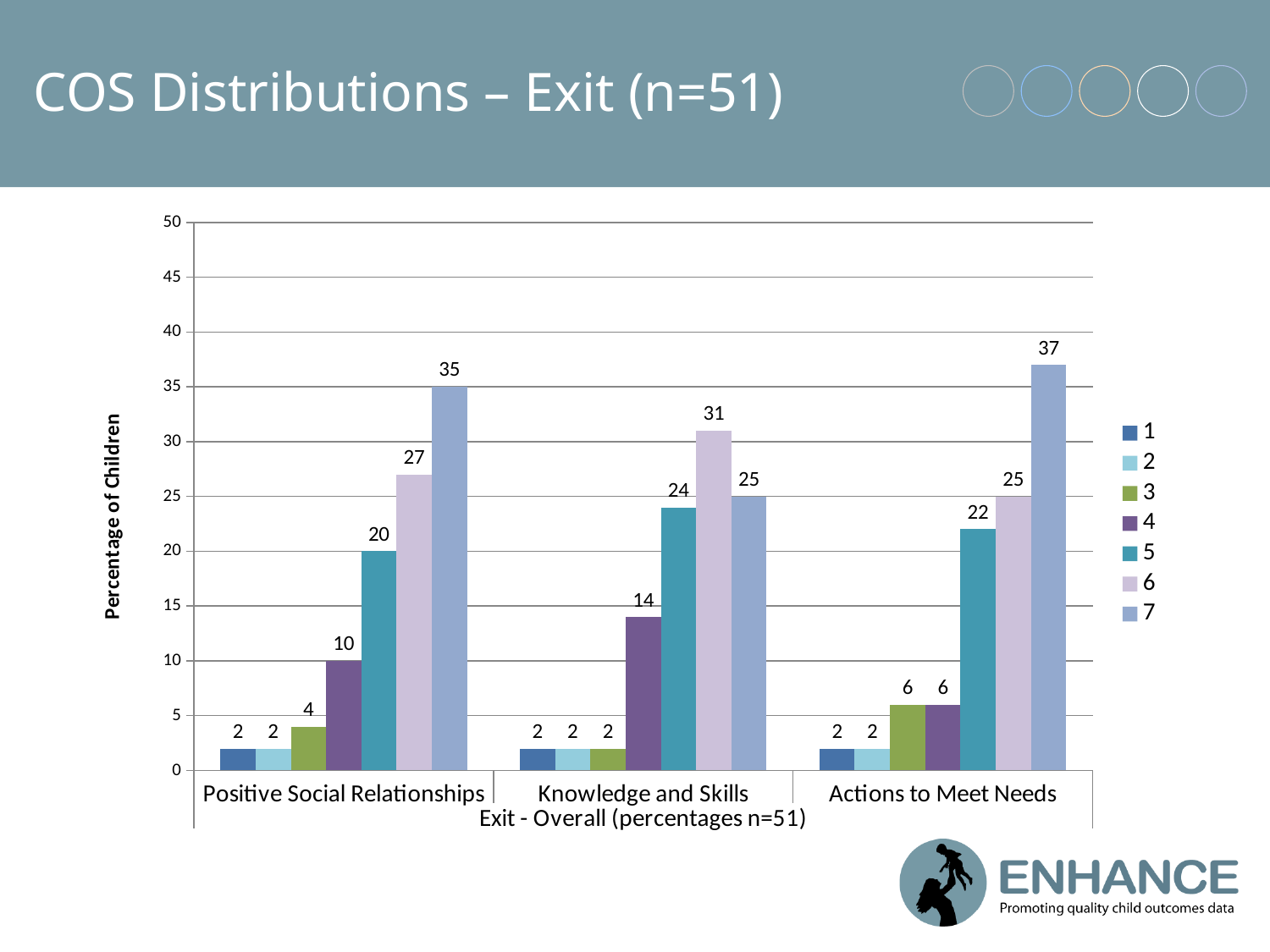
What is the value for series 6 in the Knowledge and Skills category? 31 What is the value for series 7 in the Positive Social Relationships category? 35 Which series has the highest value in the Actions to Meet Needs category? 7 Is the value for series 4 in the Knowledge and Skills category greater or less than 10? greater Which is larger: the series 7 value for Knowledge and Skills or the series 7 value for Actions to Meet Needs? Actions to Meet Needs What kind of chart is shown on the slide? bar chart How many series does the legend list? 7 How many categories are shown on the x axis? 3 What is the label of the y axis? Percentage of Children Which series has the highest value in the Knowledge and Skills category? 6 What is the difference between the series 7 value and the series 6 value in the Positive Social Relationships category? 8 What is the value for series 5 in the Actions to Meet Needs category? 22